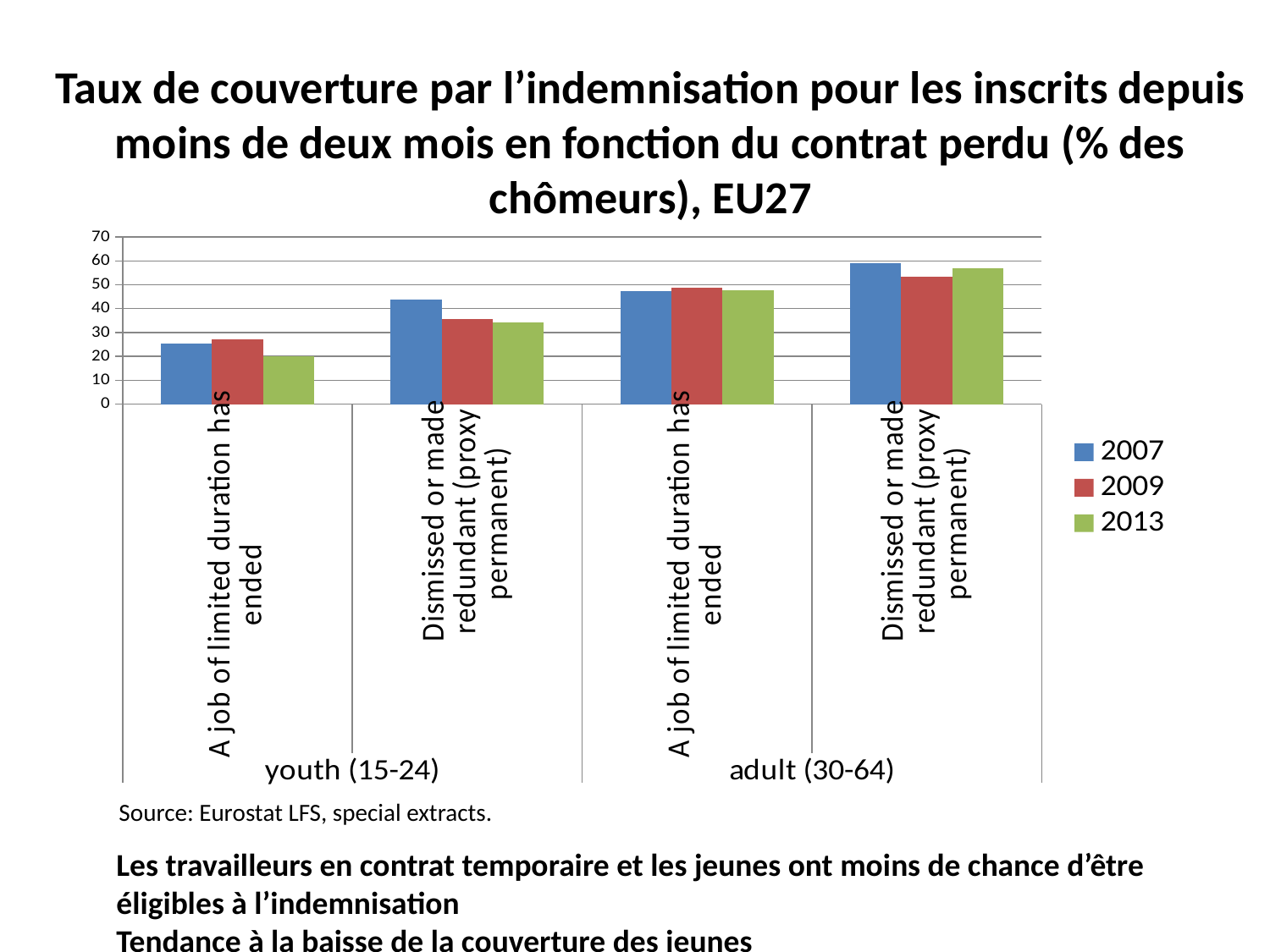
How many category groups are shown along the x axis? 4 Which category group has the highest 2007 value? Dismissed or made redundant (proxy permanent), adult (30-64) Which age group labels appear along the bottom of the chart? youth (15-24) and adult (30-64) Is the 2007 value for 'Dismissed or made redundant (proxy permanent)' in the youth (15-24) group greater or less than 40? greater How many series does the legend list? 3 Which category group has the lowest 2013 value? A job of limited duration has ended, youth (15-24) What kind of chart is shown on the slide? bar chart In the youth (15-24) 'Dismissed or made redundant (proxy permanent)' group, which is larger: the 2007 value or the 2013 value? 2007 Is the 2013 value for 'A job of limited duration has ended' in the youth (15-24) group greater or less than 30? less Is the 2009 value for 'A job of limited duration has ended' in the adult (30-64) group greater or less than 40? greater Which years are listed in the legend? 2007, 2009, 2013